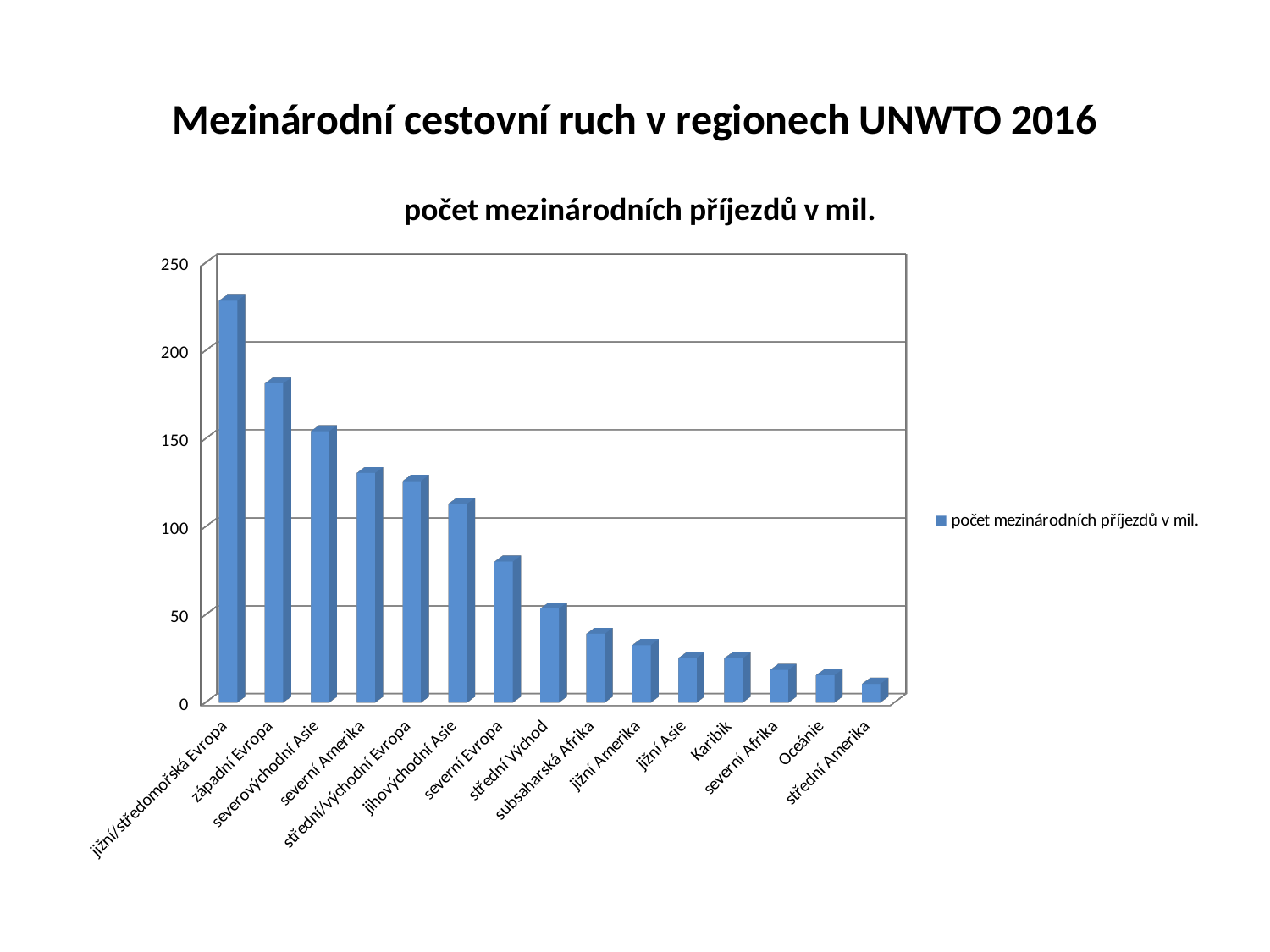
Is the value for subsaharská Afrika greater or less than 50? less What kind of chart is shown on the slide? bar chart Is the value for jižní/středomořská Evropa greater or less than 200? greater Which region has the highest number of international arrivals? jižní/středomořská Evropa Is the value for severní Evropa greater or less than 100? less Which is larger, the value for západní Evropa or the value for severovýchodní Asie? západní Evropa How many series does the legend list? 1 Which region has the lowest number of international arrivals? střední Amerika Do the values rise or fall from left to right along the x axis? fall How many regions are shown on the x axis? 15